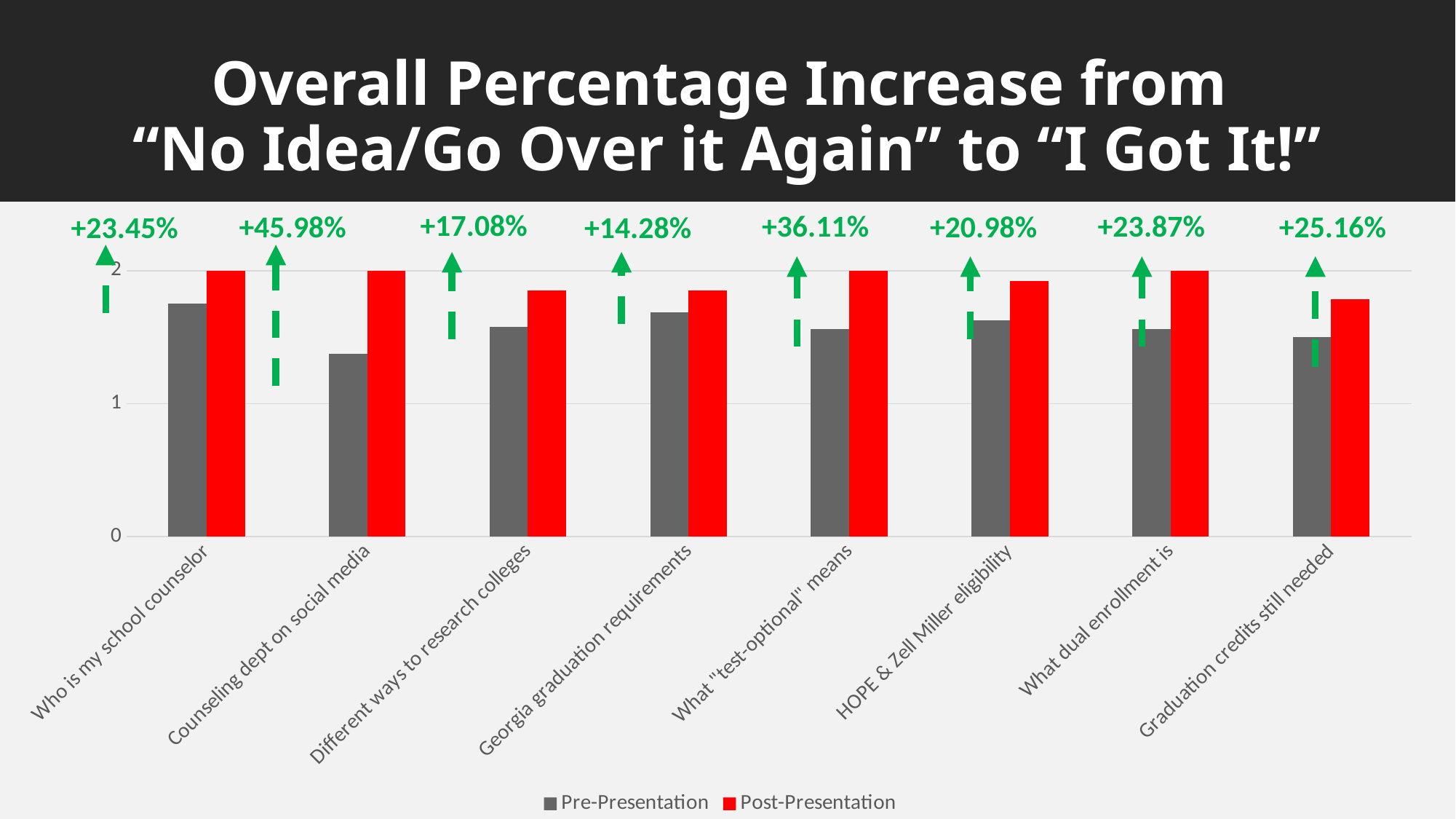
Which category has the highest percentage increase annotation? Counseling dept on social media Is the Pre-Presentation value for "Counseling dept on social media" greater or less than 1? greater What kind of chart is shown on the slide? bar chart How many series does the legend list? 2 Which category has the lowest percentage increase annotation? Georgia graduation requirements What percentage increase is shown above the bars for "What "test-optional" means"? +36.11% Is the Post-Presentation value for "Different ways to research colleges" greater or less than 2? less How many categories are shown along the x axis? 8 What percentage increase is shown above the bars for "Counseling dept on social media"? +45.98% Which is larger for "Who is my school counselor": the Pre-Presentation value or the Post-Presentation value? Post-Presentation Which colour represents the Post-Presentation series in the legend? red What is the difference between the percentage increase for "Counseling dept on social media" and for "Georgia graduation requirements"? 31.70%